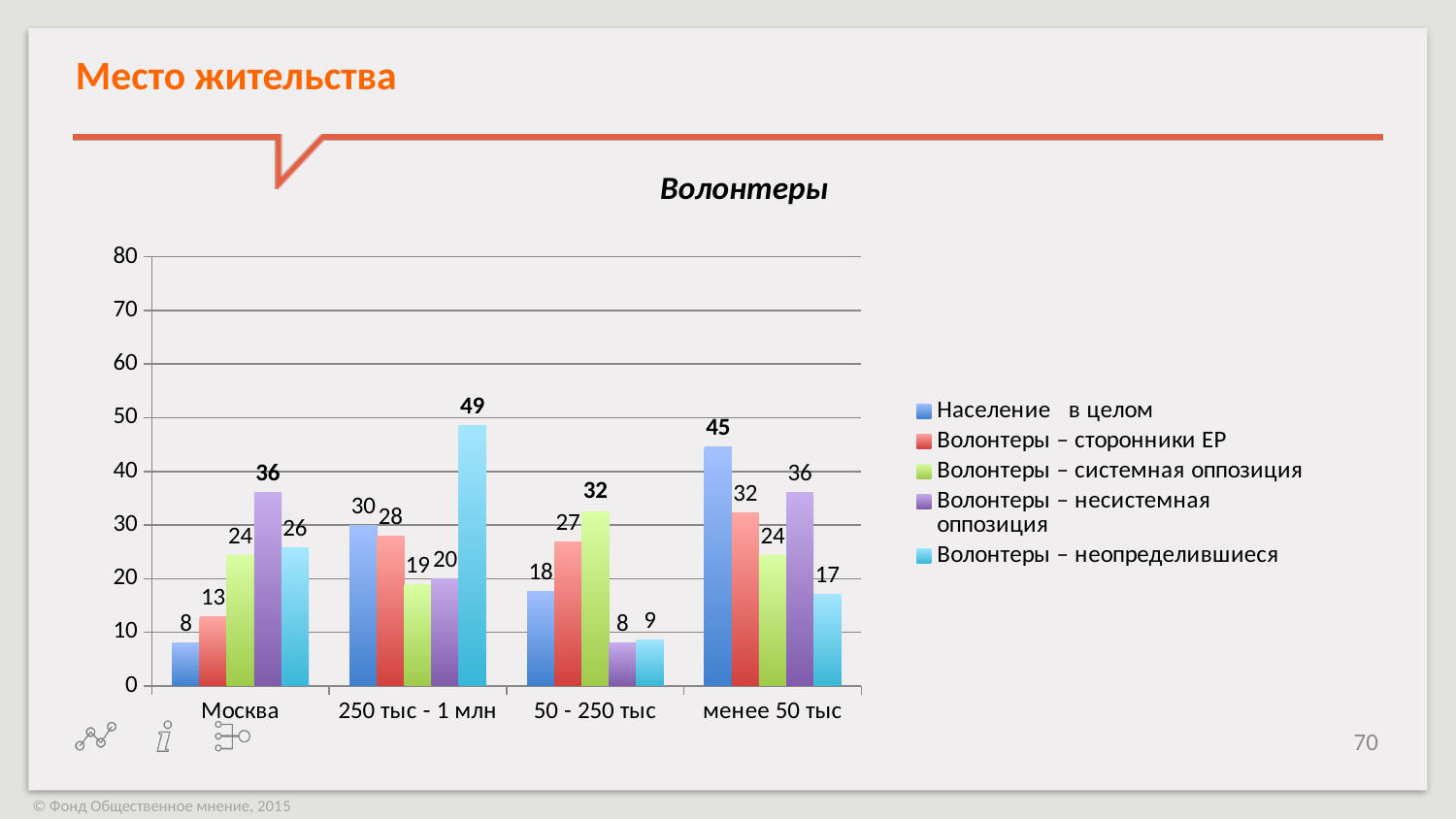
Does the value for Население в целом rise or fall from Москва to менее 50 тыс across the x axis? rise What is the difference between Волонтеры – неопределившиеся and Население в целом in the 250 тыс - 1 млн category? 19 Which category has the highest value for Население в целом? менее 50 тыс What is the value for Волонтеры – неопределившиеся in the 250 тыс - 1 млн category? 49 How many series does the legend list? 5 What is the value for Волонтеры – несистемная оппозиция in the менее 50 тыс category? 36 What type of chart is shown on the slide? bar chart What is the title of the chart? Волонтеры What is the value for Население в целом in the Москва category? 8 How many categories are shown on the x axis? 4 Which category has the lowest value for Волонтеры – несистемная оппозиция? 50 - 250 тыс Which is larger in the 50 - 250 тыс category: Волонтеры – сторонники ЕР or Волонтеры – системная оппозиция? Волонтеры – системная оппозиция